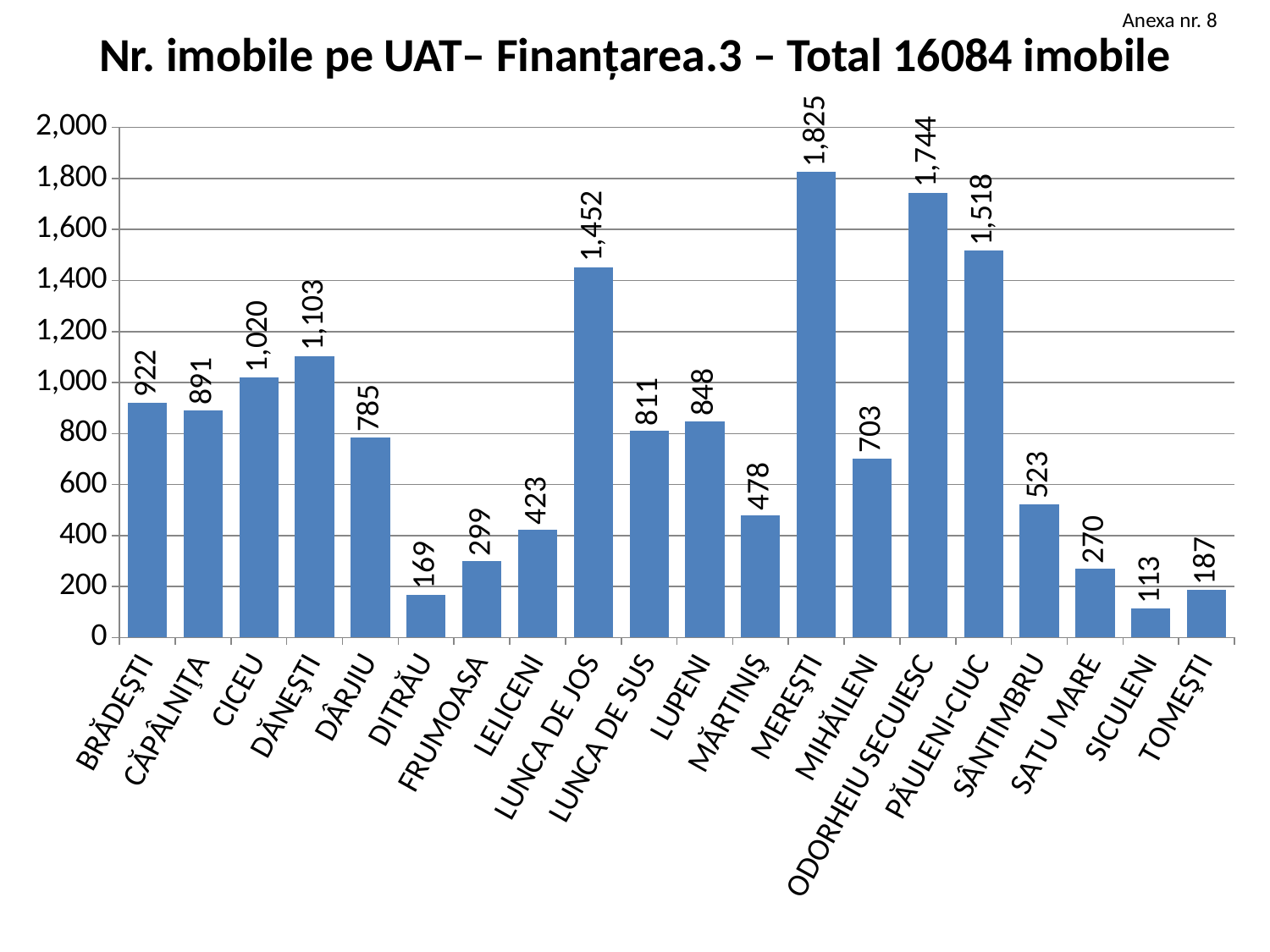
What is the difference between the values for LUNCA DE JOS and LUNCA DE SUS? 641 What is the difference between the values for MEREȘTI and ODORHEIU SECUIESC? 81 What is the value for SÂNTIMBRU? 523 What is the value for LUNCA DE JOS? 1,452 Which is larger, the value for CICEU or the value for DĂNEȘTI? DĂNEȘTI Which UAT has the highest number of imobile? MEREȘTI What is the value for DITRĂU? 169 What kind of chart is shown on the slide? bar chart What is the title of the chart? Nr. imobile pe UAT– Finanțarea.3 – Total 16084 imobile Which UAT has the lowest number of imobile? SICULENI Is the value for MIHĂILENI greater or less than 800? less How many UATs are shown on the chart? 20